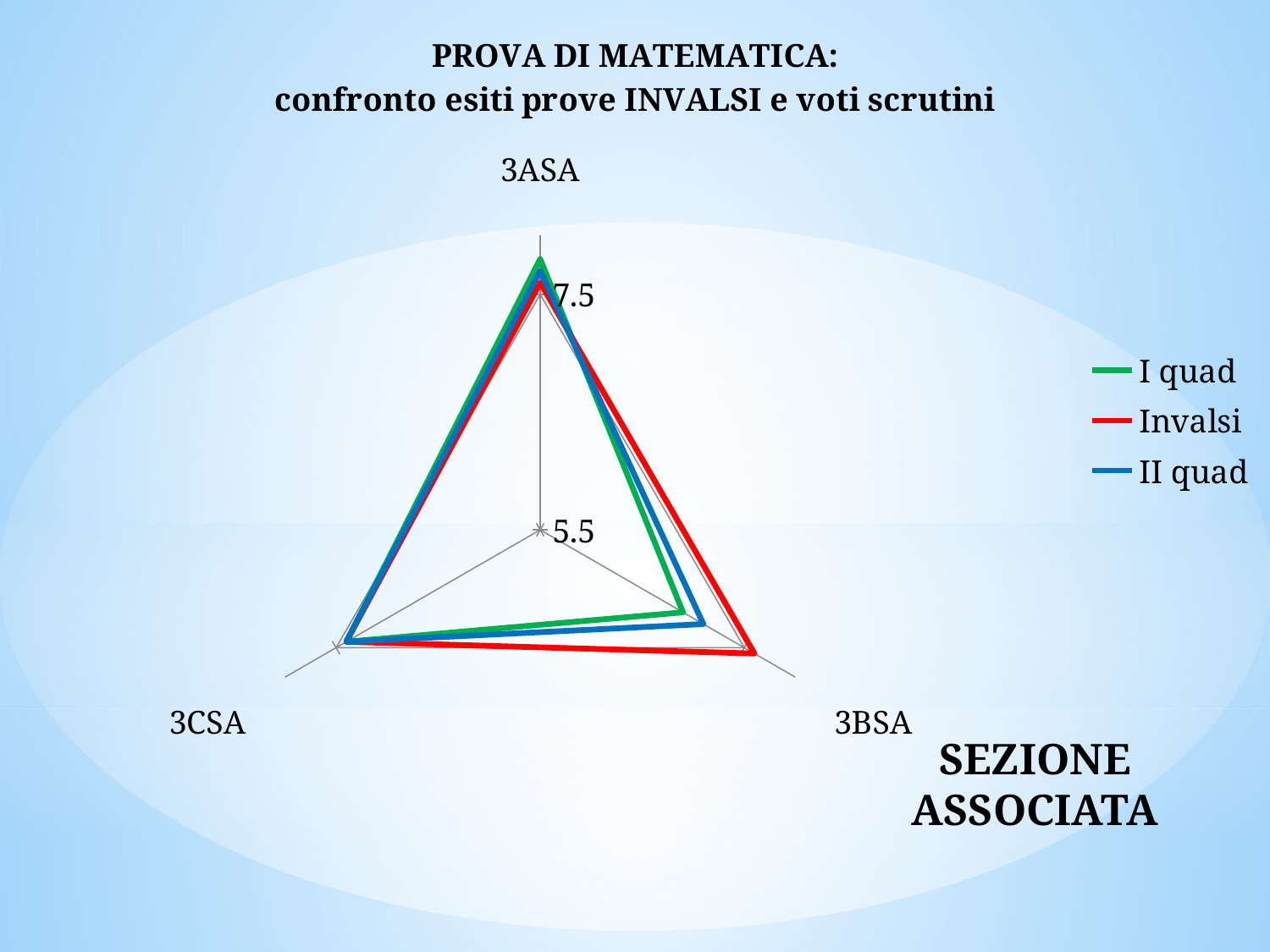
Which series is drawn in red in the legend? Invalsi Is the II quad value for 3BSA greater or less than 7.5? less Which series has the lowest value for 3BSA? I quad For 3BSA, which is larger: the II quad value or the I quad value? II quad How many categories (classes) are plotted on the radar chart? 3 What is the title of the chart? PROVA DI MATEMATICA: confronto esiti prove INVALSI e voti scrutini Is the I quad value for 3BSA greater or less than 7.5? less What kind of chart is shown on the slide? Radar chart For 3BSA, which is larger: the Invalsi value or the I quad value? Invalsi Which series has the highest value for 3BSA? Invalsi Is the I quad value for 3BSA greater or less than 5.5? greater How many series does the legend list? 3